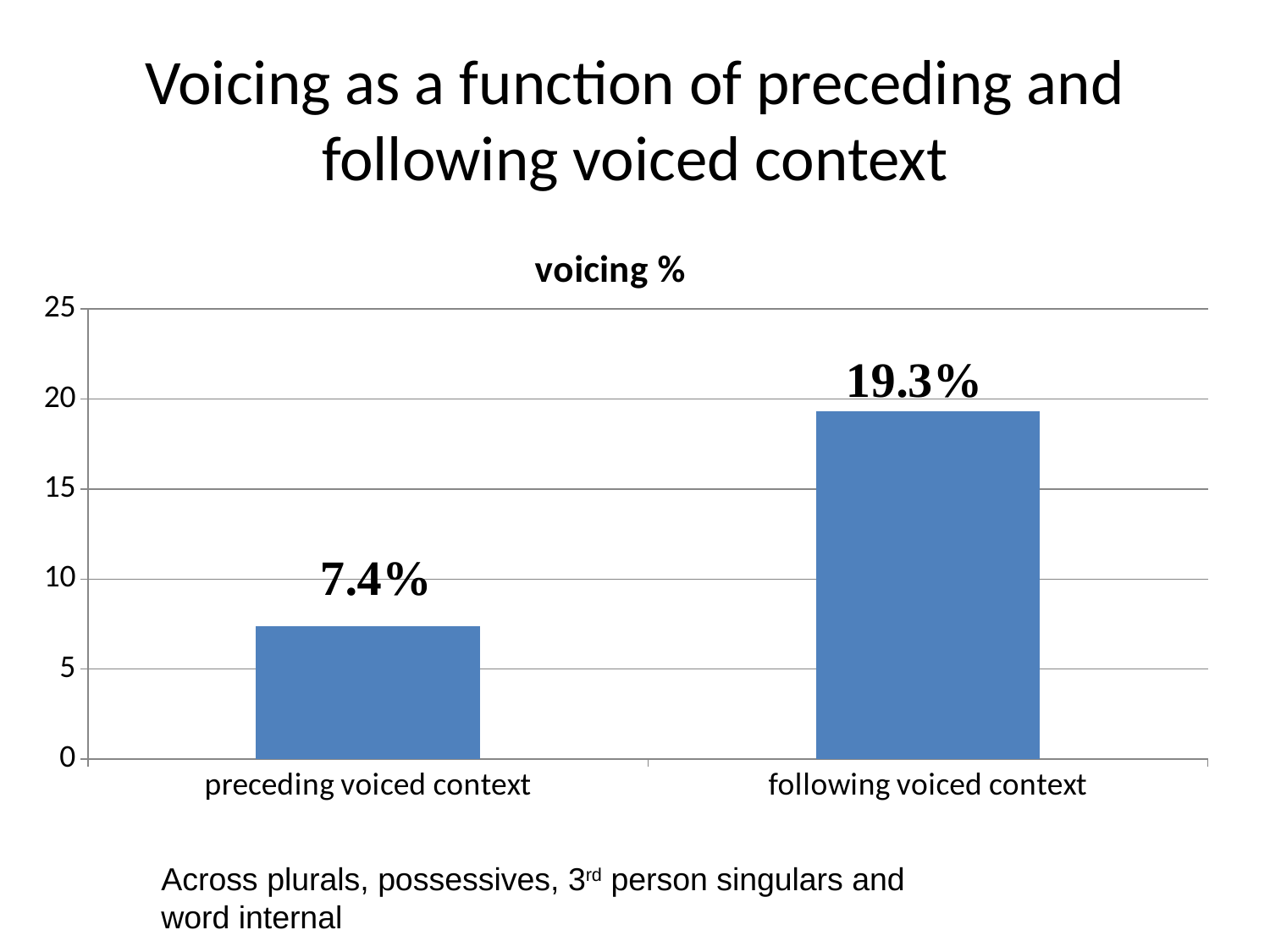
Which category has the lowest voicing %? preceding voiced context What is the voicing % for preceding voiced context? 7.4% How many categories are shown on the x axis? 2 What is the voicing % for following voiced context? 19.3% Is the value for following voiced context greater or less than 15? greater Which is larger, the voicing % for preceding voiced context or for following voiced context? following voiced context What is the highest value shown on the y axis? 25 What is the title of the chart? voicing % What kind of chart is shown on the slide? bar chart Is the value for preceding voiced context greater or less than 10? less What is the difference in voicing % between following voiced context and preceding voiced context? 11.9% Which category has the highest voicing %? following voiced context